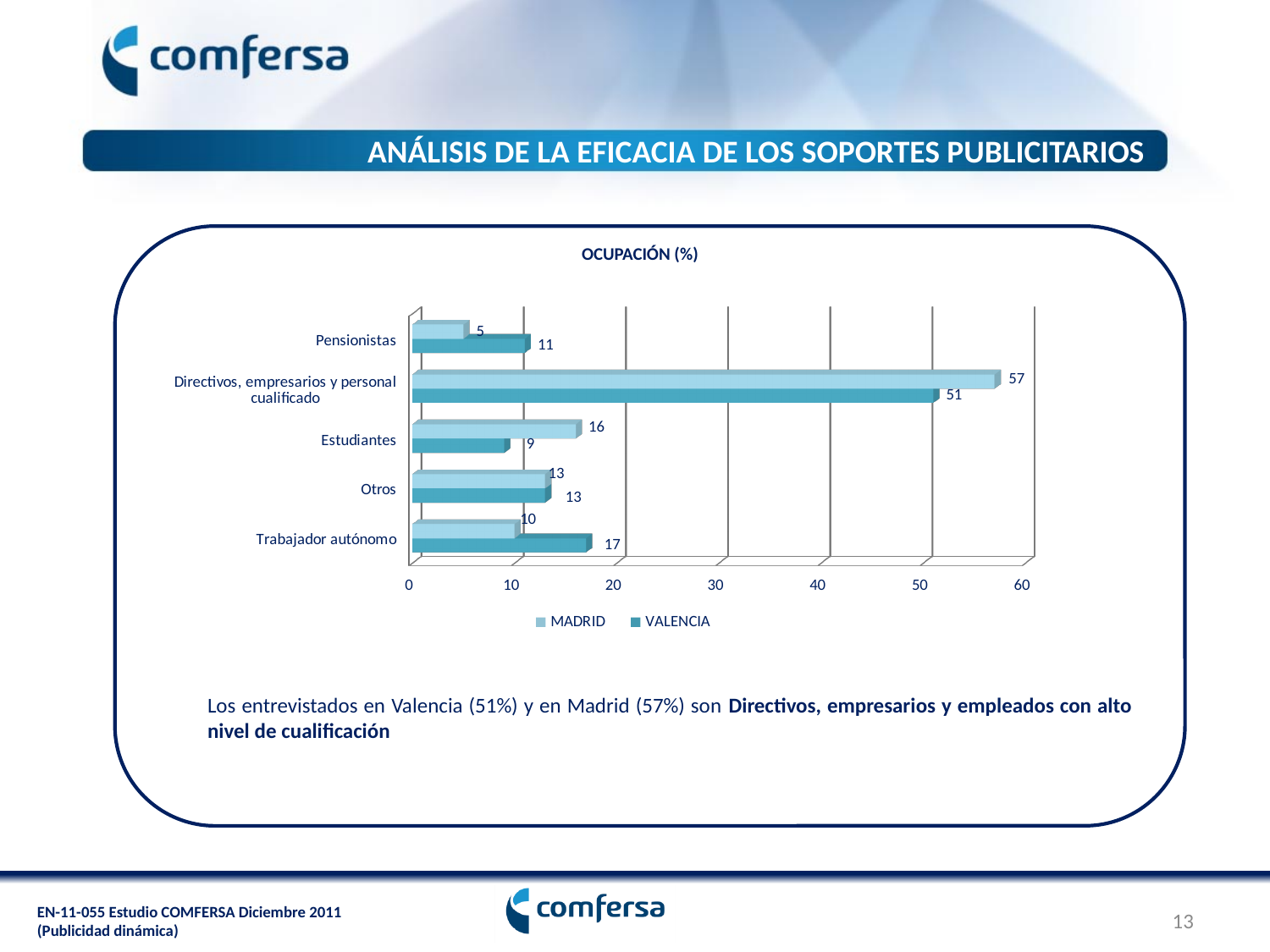
What is the VALENCIA value for Estudiantes? 9 What is the VALENCIA value for Trabajador autónomo? 17 Which series is shown in the lighter blue colour in the OCUPACIÓN (%) chart? MADRID Which category has the lowest VALENCIA value? Estudiantes Is the VALENCIA value for Directivos, empresarios y personal cualificado greater or less than 40? greater Which category has the highest MADRID value? Directivos, empresarios y personal cualificado What is the MADRID value for Pensionistas? 5 How many series does the legend of the OCUPACIÓN (%) chart list? 2 What is the difference between the MADRID and VALENCIA values for Directivos, empresarios y personal cualificado? 6 What type of chart is shown under the title OCUPACIÓN (%)? Bar chart How many occupation categories are shown in the OCUPACIÓN (%) chart? 5 For Pensionistas, which series has the larger value, MADRID or VALENCIA? VALENCIA